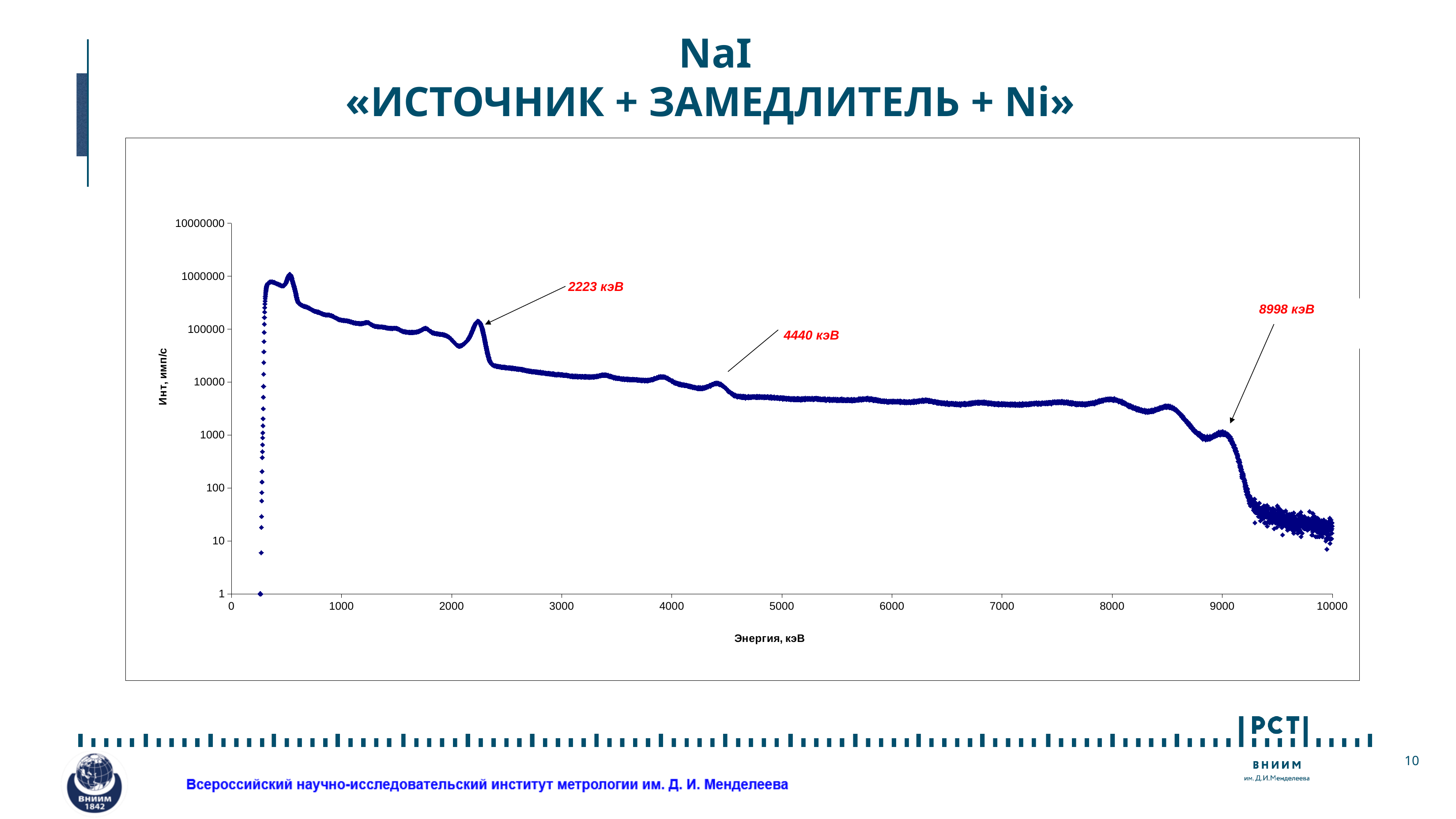
Is the highest intensity on the chart greater or less than 100000? greater What is the label of the x axis of the chart? Энергия, кэВ Is the intensity at the 2223 кэВ peak greater or less than 100000? greater Is the intensity at 10000 кэВ greater or less than 100? less What is the label of the y axis of the chart? Инт, имп/с What energy is annotated at the labelled peak near 4400 on the x axis? 4440 кэВ Overall, does the intensity rise or fall as energy increases along the x axis? fall What energy is annotated at the labelled peak near 9000 on the x axis? 8998 кэВ What kind of chart is shown on the slide? scatter chart How many energy peaks are annotated with labels on the chart? 3 What energy is annotated at the first labelled peak, near 2200 on the x axis? 2223 кэВ